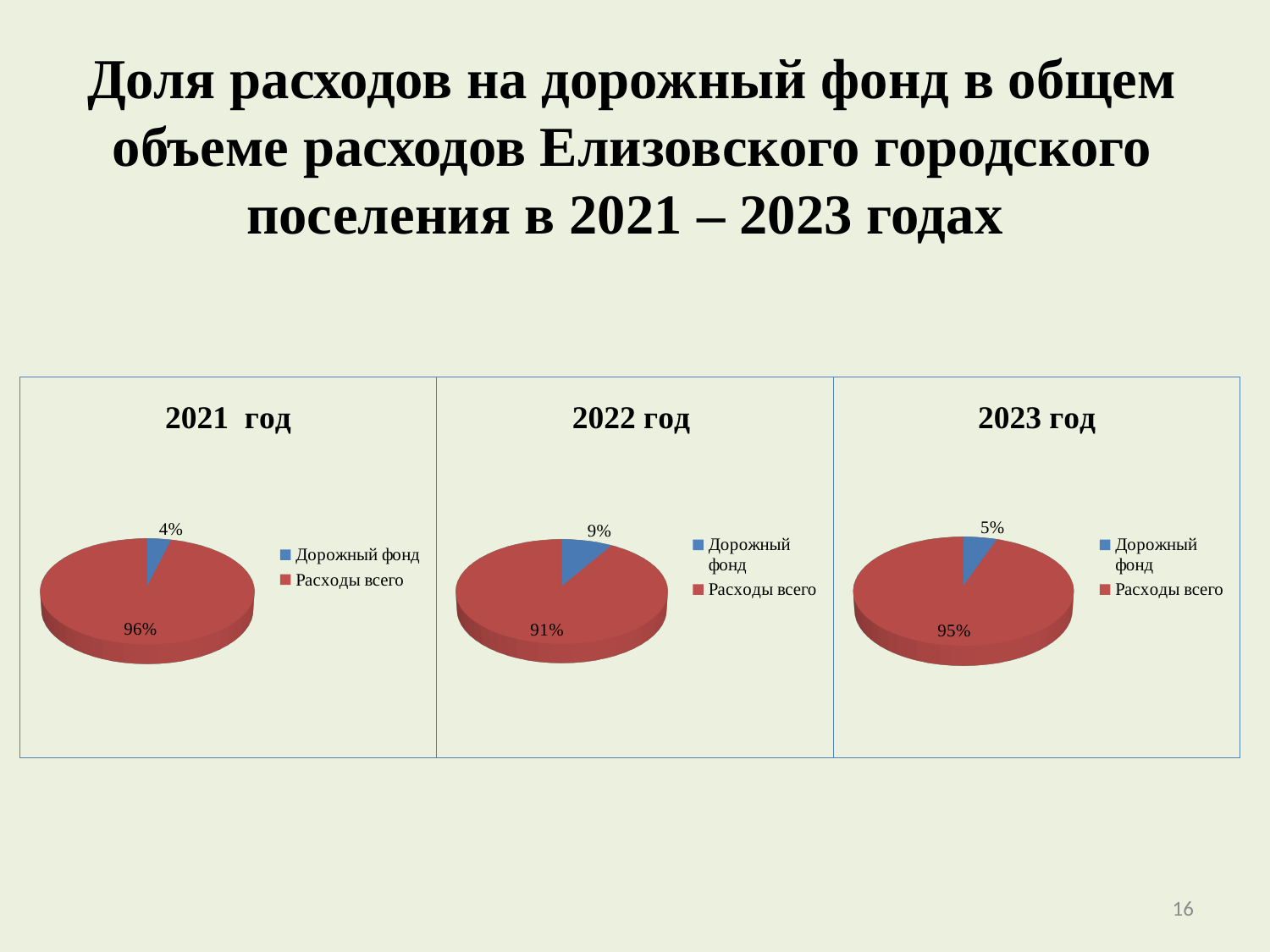
How many entries does the legend of the 2023 год chart list? 2 How many pie charts are shown on the slide? 3 What kind of chart is the 2022 год chart? Pie chart In the 2022 год chart, what share does Расходы всего have? 91% In the 2023 год chart, what share does Дорожный фонд have? 5% In the 2023 год chart, which slice is the smallest? Дорожный фонд In the 2021 год chart, what share does Расходы всего have? 96% In the 2022 год chart, what share does Дорожный фонд have? 9% In the 2021 год chart, what is the difference between the Расходы всего share and the Дорожный фонд share? 92% In the 2023 год chart, what share does Расходы всего have? 95% In the 2022 год chart, which slice is the largest? Расходы всего In the 2021 год chart, what share does Дорожный фонд have? 4%